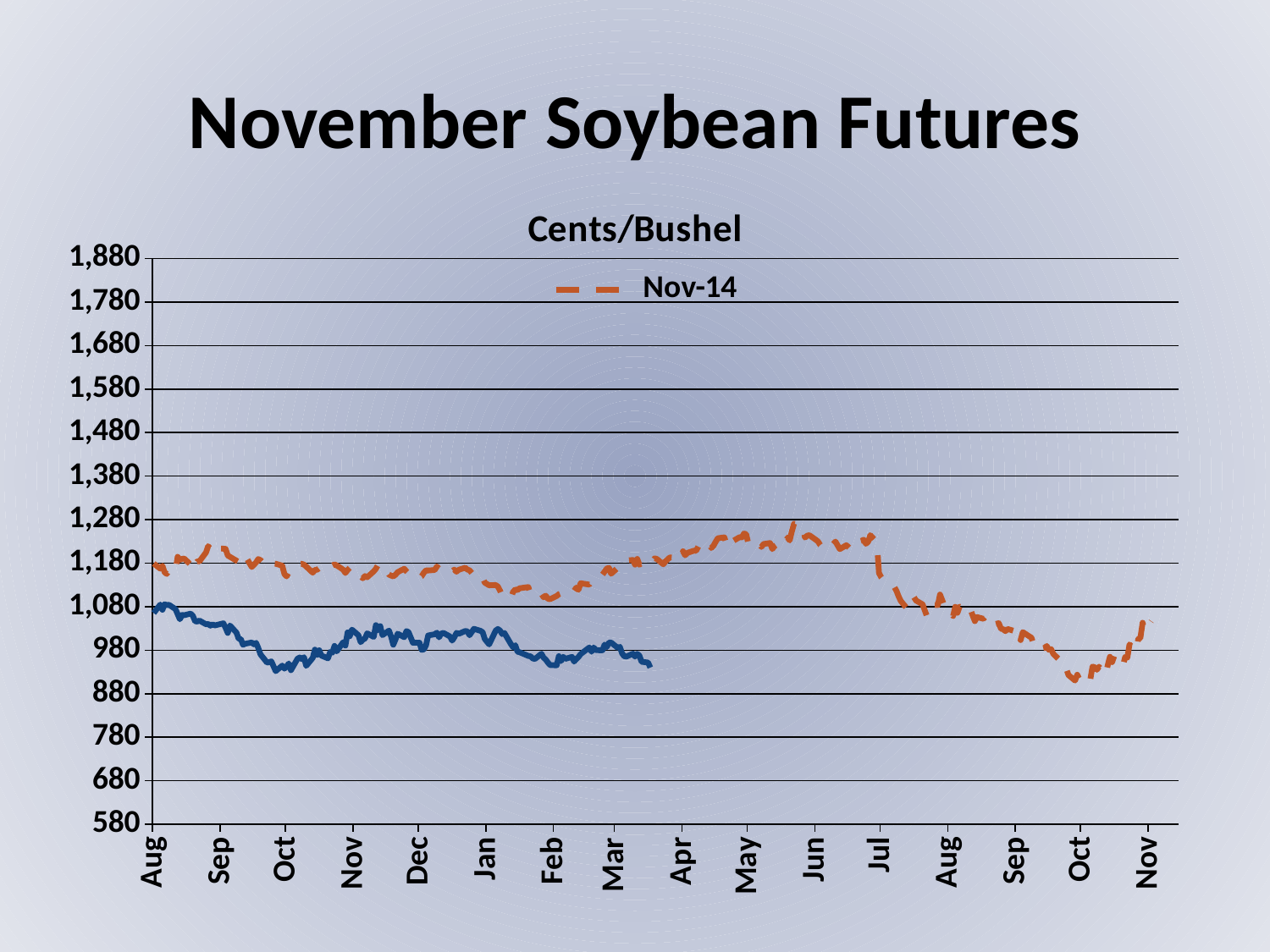
How many month labels are shown along the x axis? 16 Is the Nov-14 value at Jun greater or less than 1,180? greater How many series does the chart's legend list? 1 Is the Nov-14 value at the first Aug on the x axis greater or less than 1,080? greater What is the name of the series shown in the legend? Nov-14 Does the Nov-14 line rise or fall between Jun and the second Oct? fall Is the Nov-14 value at the second Oct on the x axis greater or less than 980? less What is the title printed above the chart's plot area? Cents/Bushel What kind of chart is shown on the slide? line chart Does the Nov-14 line rise or fall between Feb and May? rise